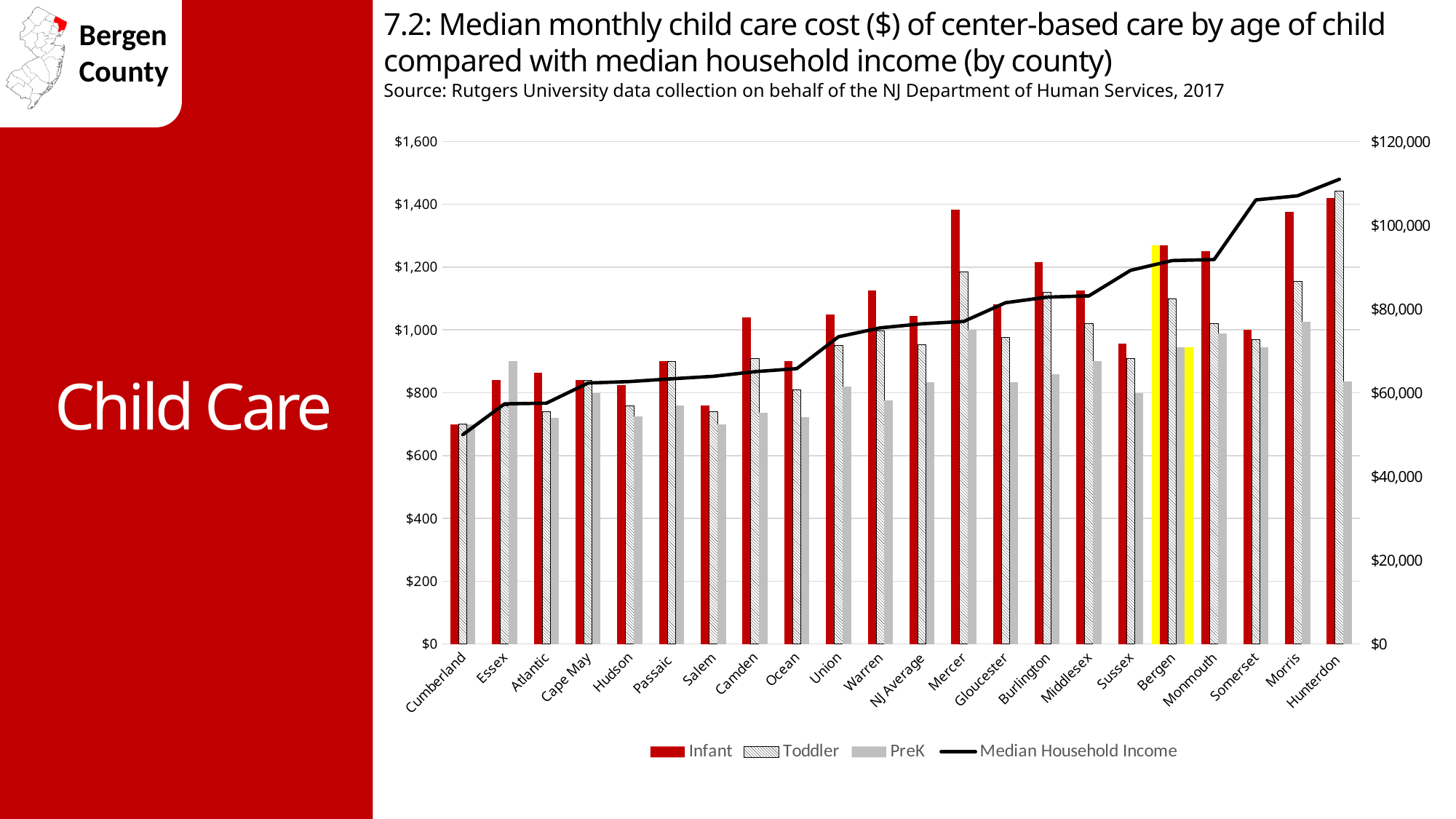
Is the Infant cost for Mercer greater or less than $1,200? greater Which county has the lowest Infant cost? Cumberland Is the Median Household Income for Cumberland greater or less than $60,000? less What kind of chart is shown on the slide? Bar chart with a line How many counties/categories are shown along the x axis? 22 Which county's bars are highlighted in yellow? Bergen Which is larger, the Infant cost for Mercer or the Infant cost for Bergen? Mercer Is the Median Household Income for Hunterdon greater or less than $100,000? greater Which county has the highest Toddler cost? Hunterdon How many series does the legend list? 4 Does the Median Household Income line generally rise or fall from left to right across the counties? rise